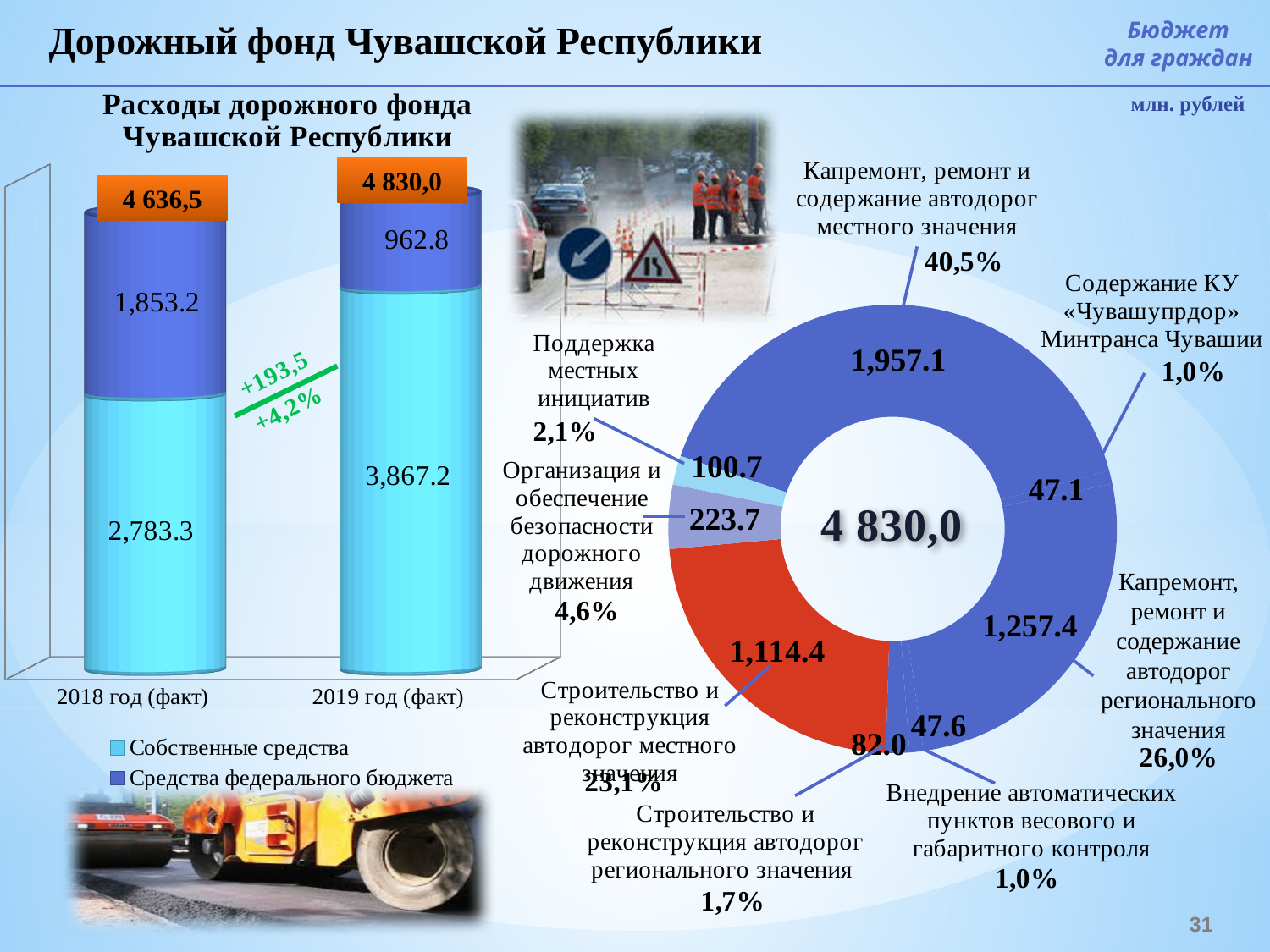
How many series does the legend of the bar chart 'Расходы дорожного фонда Чувашской Республики' list? 2 On the doughnut chart, what is the value for Капремонт, ремонт и содержание автодорог местного значения? 1,957.1 On the bar chart 'Расходы дорожного фонда Чувашской Республики', what is the value of Средства федерального бюджета for 2018 год (факт)? 1,853.2 On the doughnut chart, what share does Капремонт, ремонт и содержание автодорог регионального значения have? 26,0% On the doughnut chart, what is the value for Организация и обеспечение безопасности дорожного движения? 223.7 On the bar chart 'Расходы дорожного фонда Чувашской Республики', what is the total for 2018 год (факт)? 4 636,5 On the bar chart 'Расходы дорожного фонда Чувашской Республики', by how much did Собственные средства increase from 2018 to 2019? 1,083.9 What type of chart is the chart on the right side of the slide with the total 4 830,0 in the centre? Doughnut chart On the bar chart 'Расходы дорожного фонда Чувашской Республики', what is the value of Собственные средства for 2019 год (факт)? 3,867.2 On the bar chart 'Расходы дорожного фонда Чувашской Республики', which year has the larger value of Средства федерального бюджета? 2018 год (факт) On the doughnut chart, which category has the largest value? Капремонт, ремонт и содержание автодорог местного значения On the doughnut chart, what is the difference between Строительство и реконструкция автодорог местного значения and Строительство и реконструкция автодорог регионального значения? 1,032.4